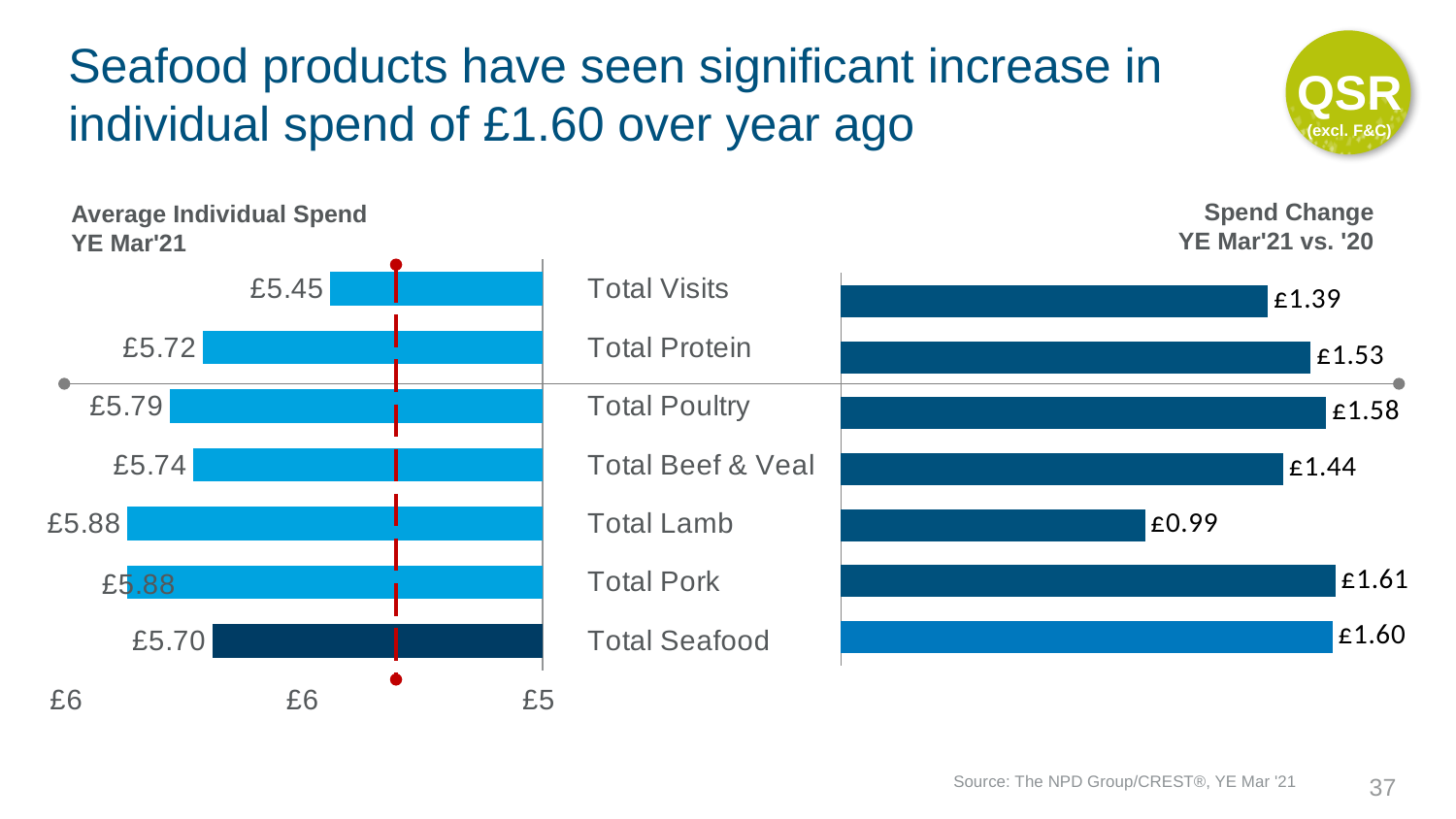
In the Spend Change YE Mar'21 vs. '20 chart, what is the value for Total Lamb? £0.99 How many categories are shown in the Spend Change YE Mar'21 vs. '20 chart? 7 In the Spend Change YE Mar'21 vs. '20 chart, what is the difference between Total Poultry and Total Beef & Veal? £0.14 In the Spend Change YE Mar'21 vs. '20 chart, which is larger, Total Protein or Total Visits? Total Protein In the Average Individual Spend YE Mar'21 chart, what is the value for Total Visits? £5.45 In the Average Individual Spend YE Mar'21 chart, which category's bar is shown in a darker blue than the others? Total Seafood In the Average Individual Spend YE Mar'21 chart, what is the value for Total Poultry? £5.79 What kind of chart is the Average Individual Spend YE Mar'21 chart? Bar chart In the Average Individual Spend YE Mar'21 chart, what is the difference between Total Lamb and Total Seafood? £0.18 In the Average Individual Spend YE Mar'21 chart, which category has the lowest value? Total Visits In the Spend Change YE Mar'21 vs. '20 chart, what is the value for Total Seafood? £1.60 In the Spend Change YE Mar'21 vs. '20 chart, which category has the lowest value? Total Lamb